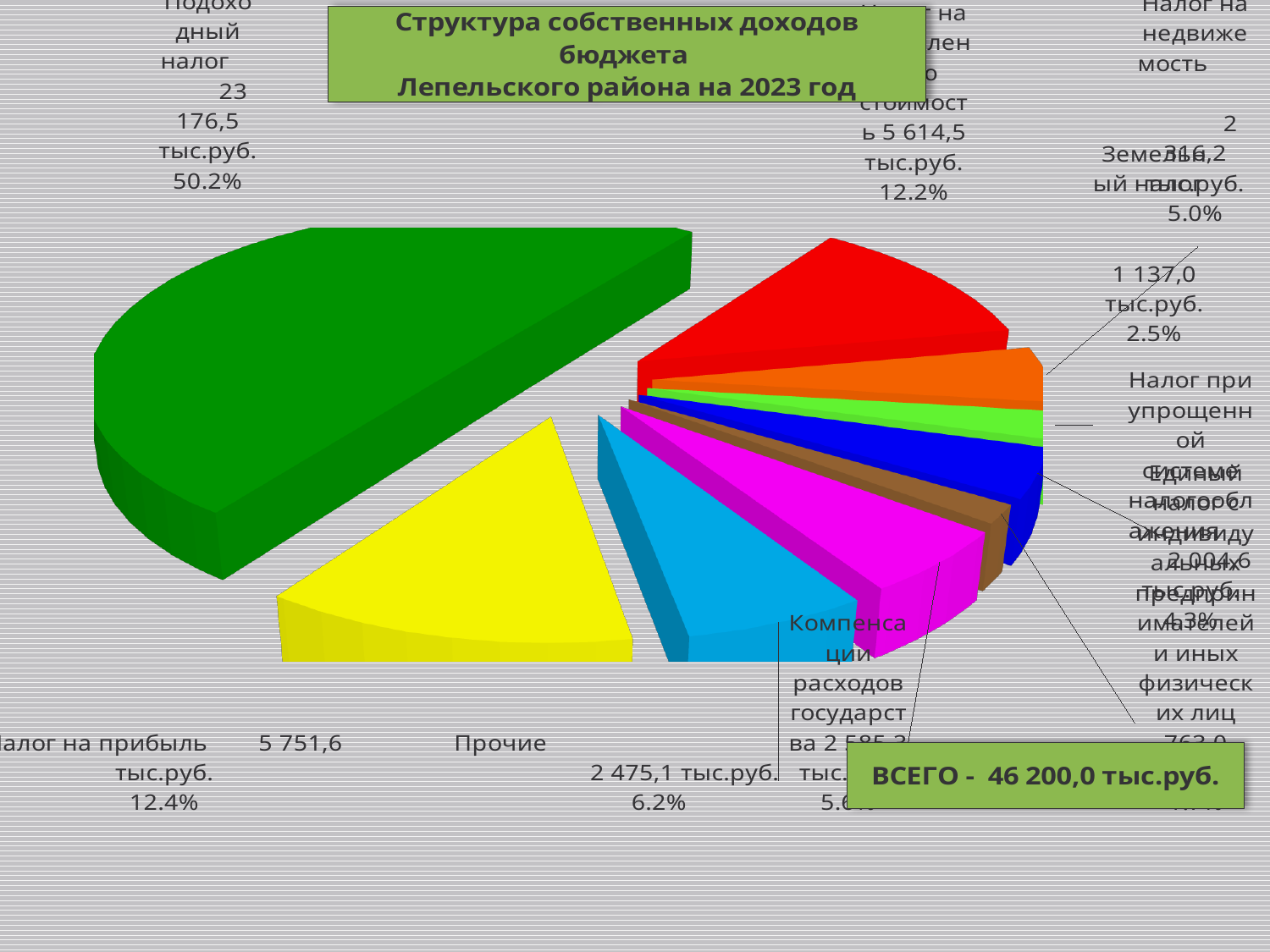
What is the value shown for Прочие? 2 475,1 тыс.руб. Which category has the largest slice of the pie? Подоходный налог What is the value shown for Налог на прибыль? 5 751,6 тыс.руб. What share of the pie does Прочие account for? 6.2% How many slices does the pie chart have? 9 What is the title of the chart? Структура собственных доходов бюджета Лепельского района на 2023 год What is the value shown for Подоходный налог? 23 176,5 тыс.руб. What kind of chart is shown on the slide? pie chart What is the difference between the values for Налог на прибыль and Прочие? 3 276,5 тыс.руб. What is the total (ВСЕГО) shown on the slide? 46 200,0 тыс.руб. What share of the pie does Подоходный налог account for? 50.2% Which is larger, Налог на прибыль or Прочие? Налог на прибыль